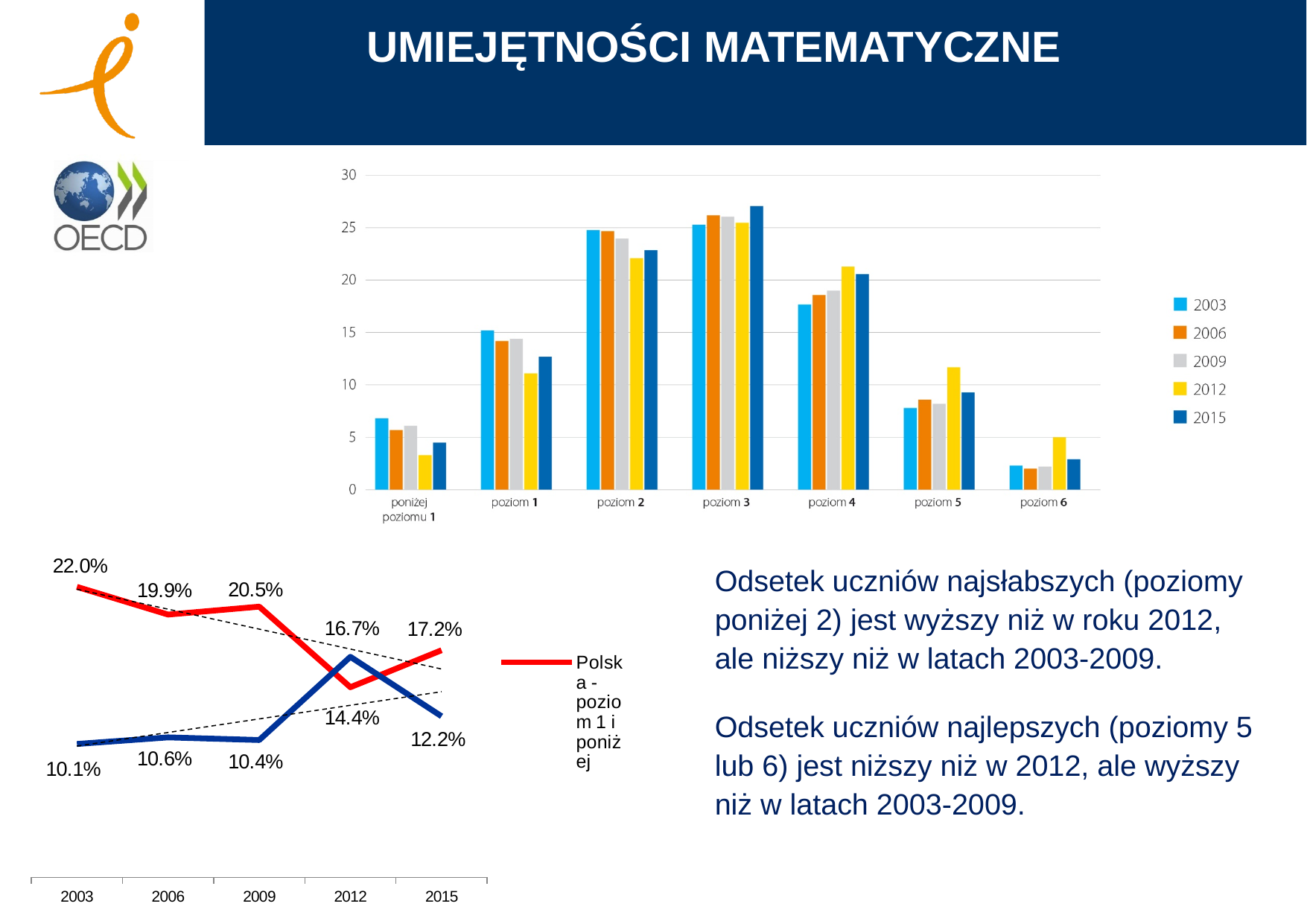
In the line chart at the bottom left, what is the value of the blue line in 2012? 16.7% In the line chart at the bottom left, what is the value of the red line (Polska - poziom 1 i poniżej) in 2012? 14.4% What kind of chart is the chart at the top of the slide? bar chart In the bar chart at the top of the slide, which year has the highest bar for poziom 5? 2012 In the line chart at the bottom left, what is the value of the red line (Polska - poziom 1 i poniżej) in 2003? 22.0% In the bar chart at the top of the slide, which category has the highest bars overall? poziom 3 In the bar chart at the top of the slide, is the 2012 value for poziom 1 greater or less than 15? less In the bar chart at the top of the slide, how many series does the legend list? 5 In the bar chart at the top of the slide, is the 2015 value for poziom 3 greater or less than 25? greater In the line chart at the bottom left, what is the difference between the red line's values in 2003 and 2015? 4.8% In the bar chart at the top of the slide, how many categories are shown on the x axis? 7 In the line chart at the bottom left, in which year is the red line (Polska - poziom 1 i poniżej) lowest? 2012